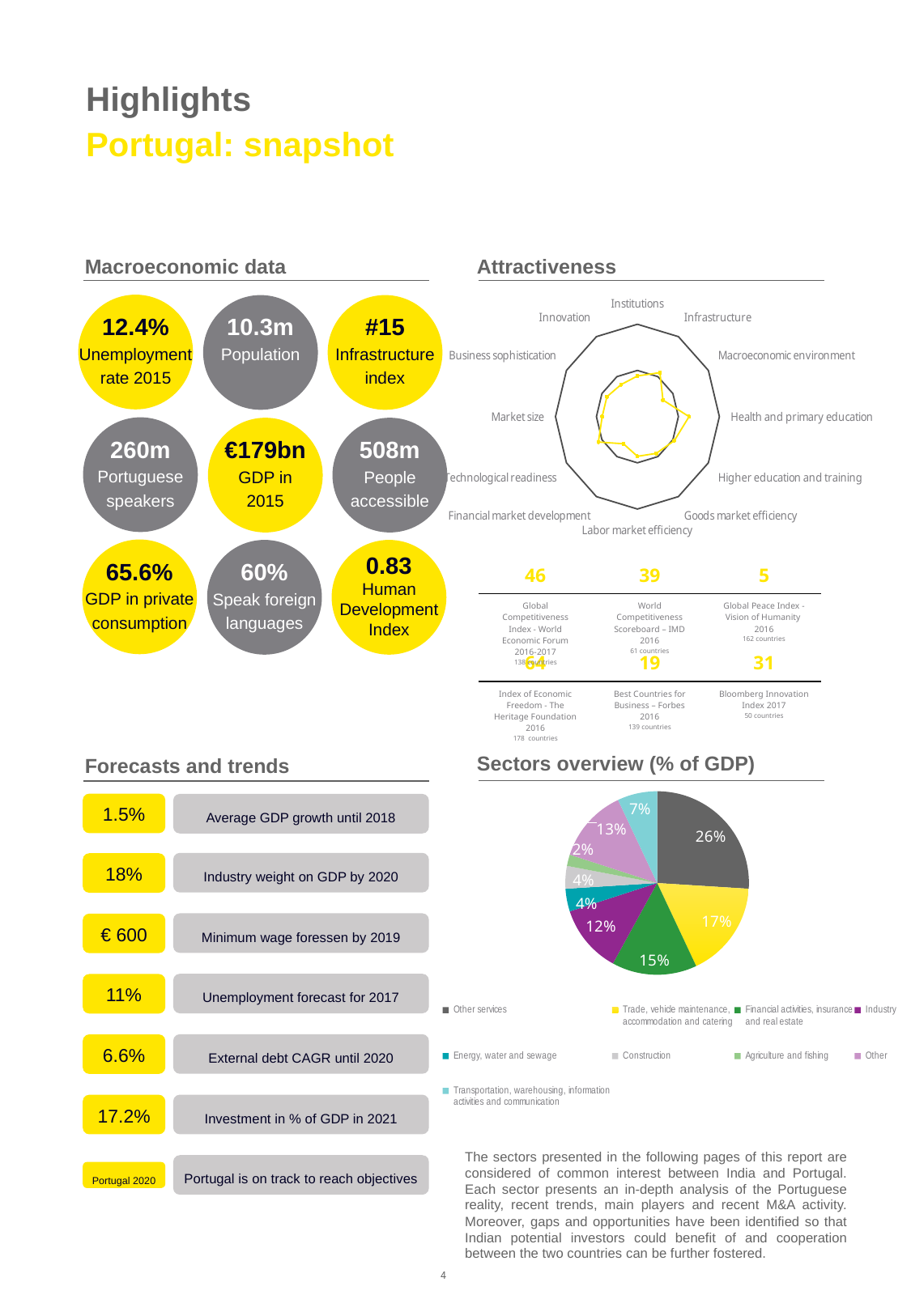
In the Sectors overview (% of GDP) chart, which sector has the smallest share? Agriculture and fishing In the Sectors overview (% of GDP) chart, what is the difference between the shares of Other services and Financial activities, insurance and real estate? 11% In the Sectors overview (% of GDP) chart, what is the value for Transportation, warehousing, information activities and communication? 7% In the Sectors overview (% of GDP) chart, what is the value for Trade, vehicle maintenance, accommodation and catering? 17% What kind of chart is shown under the Attractiveness heading? Radar chart How many sectors are listed in the legend of the Sectors overview (% of GDP) chart? 9 In the Sectors overview (% of GDP) chart, which is larger: Industry or Other? Other In the Sectors overview (% of GDP) chart, which sector has the largest share? Other services In the Sectors overview (% of GDP) chart, what share of GDP does Other services account for? 26% What kind of chart is the Sectors overview (% of GDP) chart? Pie chart How many categories (axes) does the Attractiveness radar chart have? 12 In the Sectors overview (% of GDP) chart, what is the value for Industry? 12%